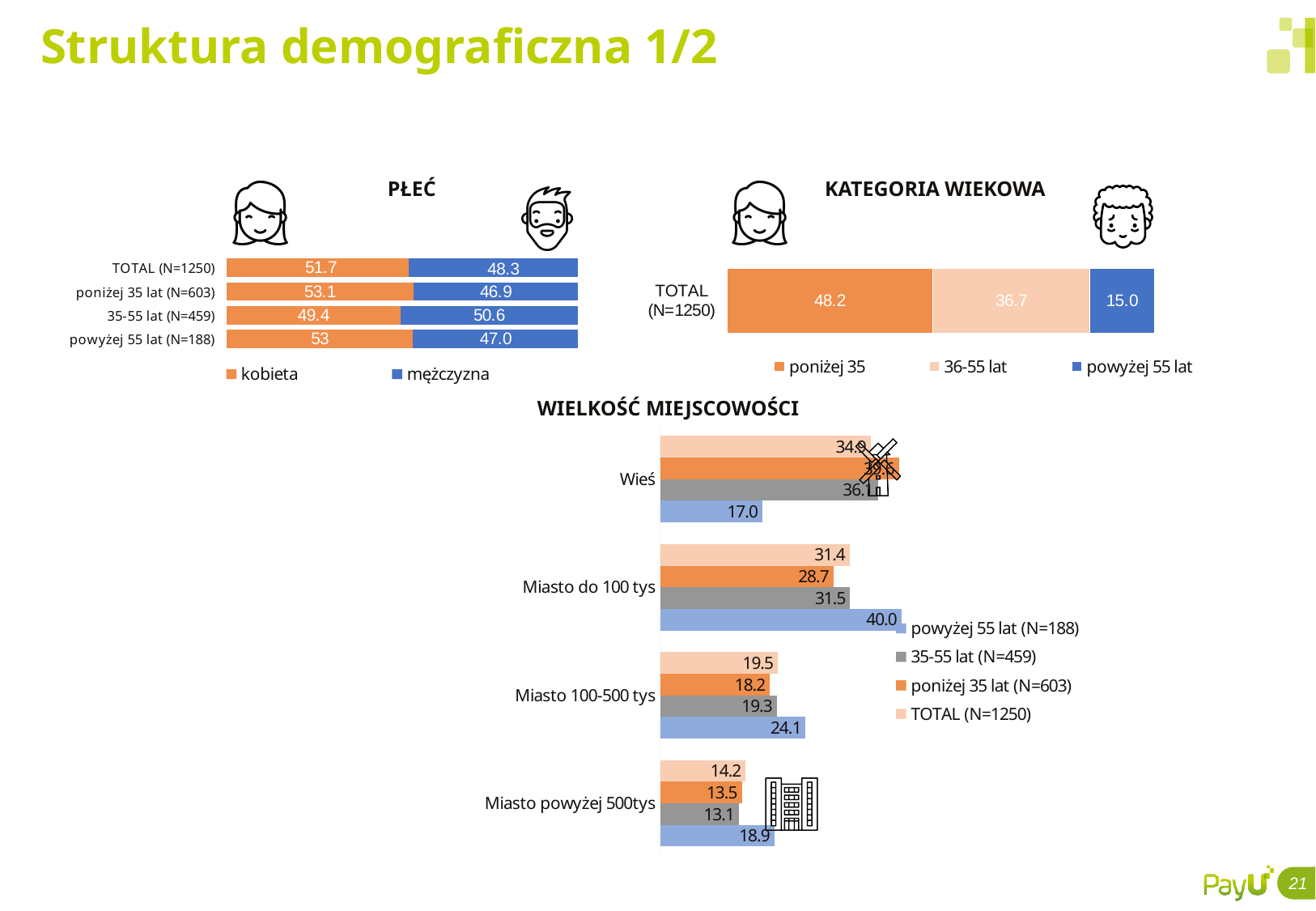
In the PŁEĆ chart, what is the value for mężczyzna in the 35-55 lat (N=459) row? 50.6 In the KATEGORIA WIEKOWA chart, what is the difference between the poniżej 35 and 36-55 lat values? 11.5 In the WIELKOŚĆ MIEJSCOWOŚCI chart, what is the value for powyżej 55 lat (N=188) in Miasto do 100 tys? 40.0 In the PŁEĆ chart, what is the value for kobieta in the TOTAL (N=1250) row? 51.7 In the WIELKOŚĆ MIEJSCOWOŚCI chart, what is the TOTAL (N=1250) value for Miasto powyżej 500tys? 14.2 How many locality categories are shown in the WIELKOŚĆ MIEJSCOWOŚCI chart? 4 In the KATEGORIA WIEKOWA chart, which age group has the smallest segment? powyżej 55 lat How many series does the legend of the WIELKOŚĆ MIEJSCOWOŚCI chart list? 4 What kind of chart is the PŁEĆ chart? bar chart In the WIELKOŚĆ MIEJSCOWOŚCI chart, for powyżej 55 lat (N=188), which is larger: Wieś or Miasto 100-500 tys? Miasto 100-500 tys How many series does the legend of the PŁEĆ chart list? 2 In the KATEGORIA WIEKOWA chart, what is the value for poniżej 35? 48.2